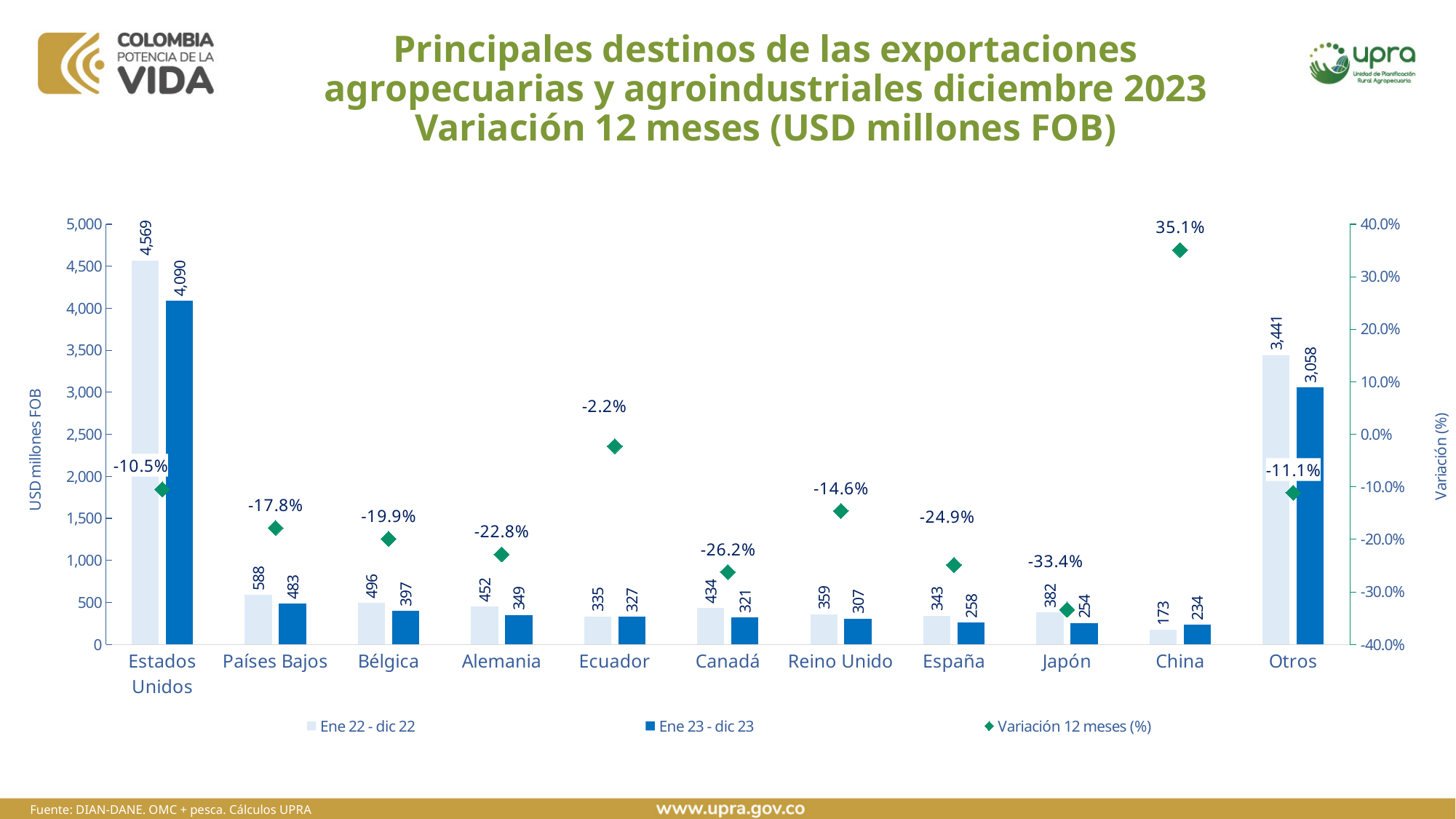
What is the Variación 12 meses (%) value for China? 35.1% How many categories are shown on the x axis? 11 Which country (excluding Otros) has the lowest Ene 22 - dic 22 value? China What is the Variación 12 meses (%) value for Japón? -33.4% Which is larger for Canadá: the Ene 22 - dic 22 value or the Ene 23 - dic 23 value? Ene 22 - dic 22 What kind of chart is used for the Ene 22 - dic 22 and Ene 23 - dic 23 series? Bar chart What is the Ene 23 - dic 23 value for Estados Unidos? 4,090 What is the difference between the Ene 22 - dic 22 and Ene 23 - dic 23 values for Alemania? 103 Which category has the highest Ene 23 - dic 23 value? Estados Unidos What is the Ene 22 - dic 22 value for Países Bajos? 588 How many series does the legend list? 3 What is the label of the right-hand vertical axis? Variación (%)